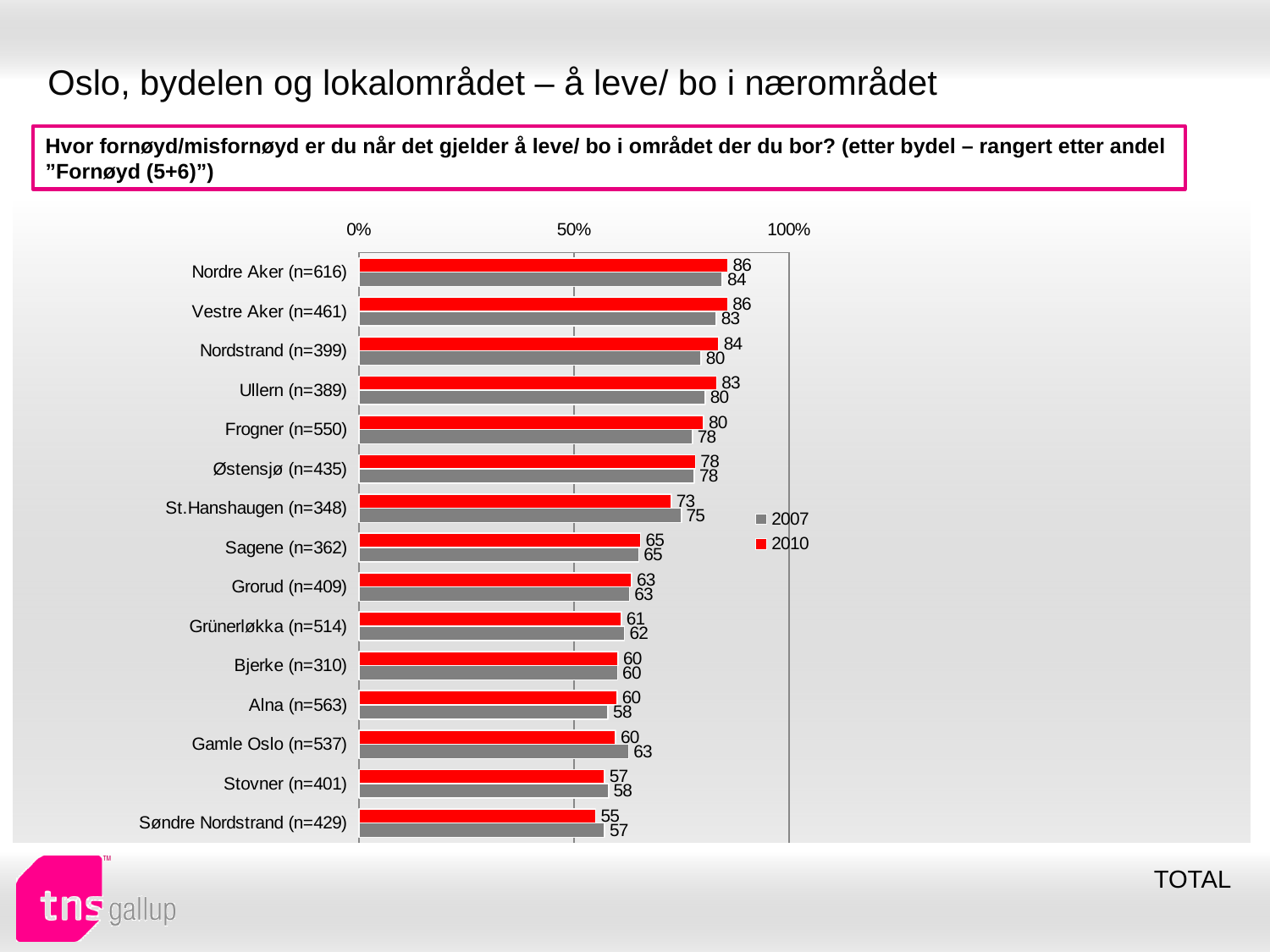
What is the 2010 value for Gamle Oslo (n=537)? 60 For Gamle Oslo (n=537), which is larger: the 2007 value or the 2010 value? 2007 What is the 2010 value for Nordstrand (n=399)? 84 What is the 2007 value for St.Hanshaugen (n=348)? 75 What is the difference between the 2010 and 2007 values for Nordstrand (n=399)? 4 How many series does the legend list? 2 Which district has the lowest 2010 value? Søndre Nordstrand (n=429) What is the difference between the 2010 values for Vestre Aker (n=461) and Sagene (n=362)? 21 Is the 2010 value for Frogner (n=550) greater or less than 50%? greater How many districts are shown in the chart? 15 What type of chart is shown on the slide? Bar chart Which district has the highest 2007 value? Nordre Aker (n=616)